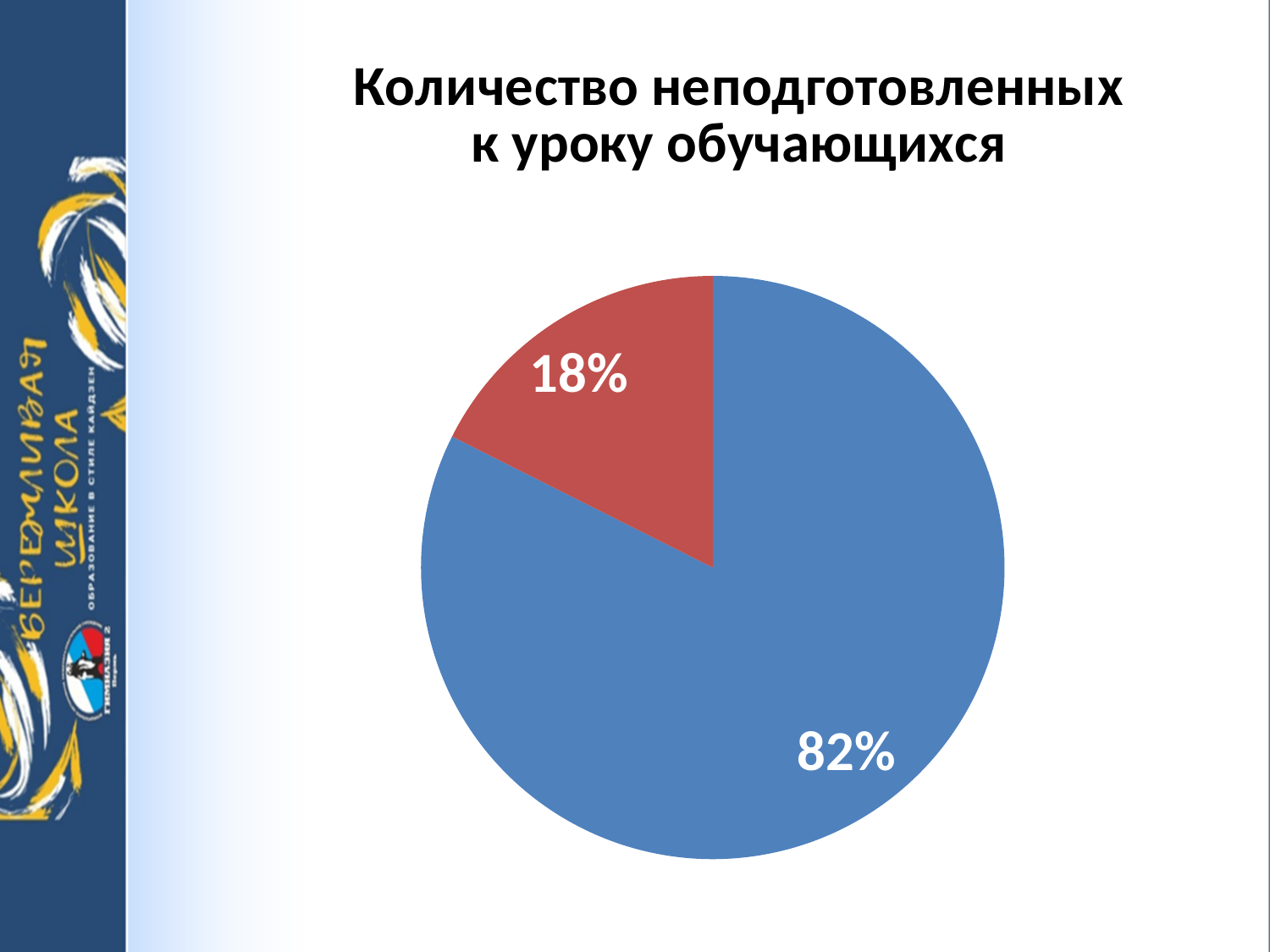
What percentage is shown on the blue slice of the pie chart? 82% What share of the pie does the red slice represent? 18% How many slices does the pie chart have? 2 Which slice of the pie chart is the largest? the blue slice (82%) Which slice of the pie chart is the smallest? the red slice (18%) What percentage is shown on the red slice of the pie chart? 18% What colour is the slice labelled 82%? blue Which slice is larger, the blue one or the red one? the blue one What is the difference in percentage points between the blue slice and the red slice? 64 What kind of chart is shown on the slide? pie chart What is the title of the chart on the slide? Количество неподготовленных к уроку обучающихся